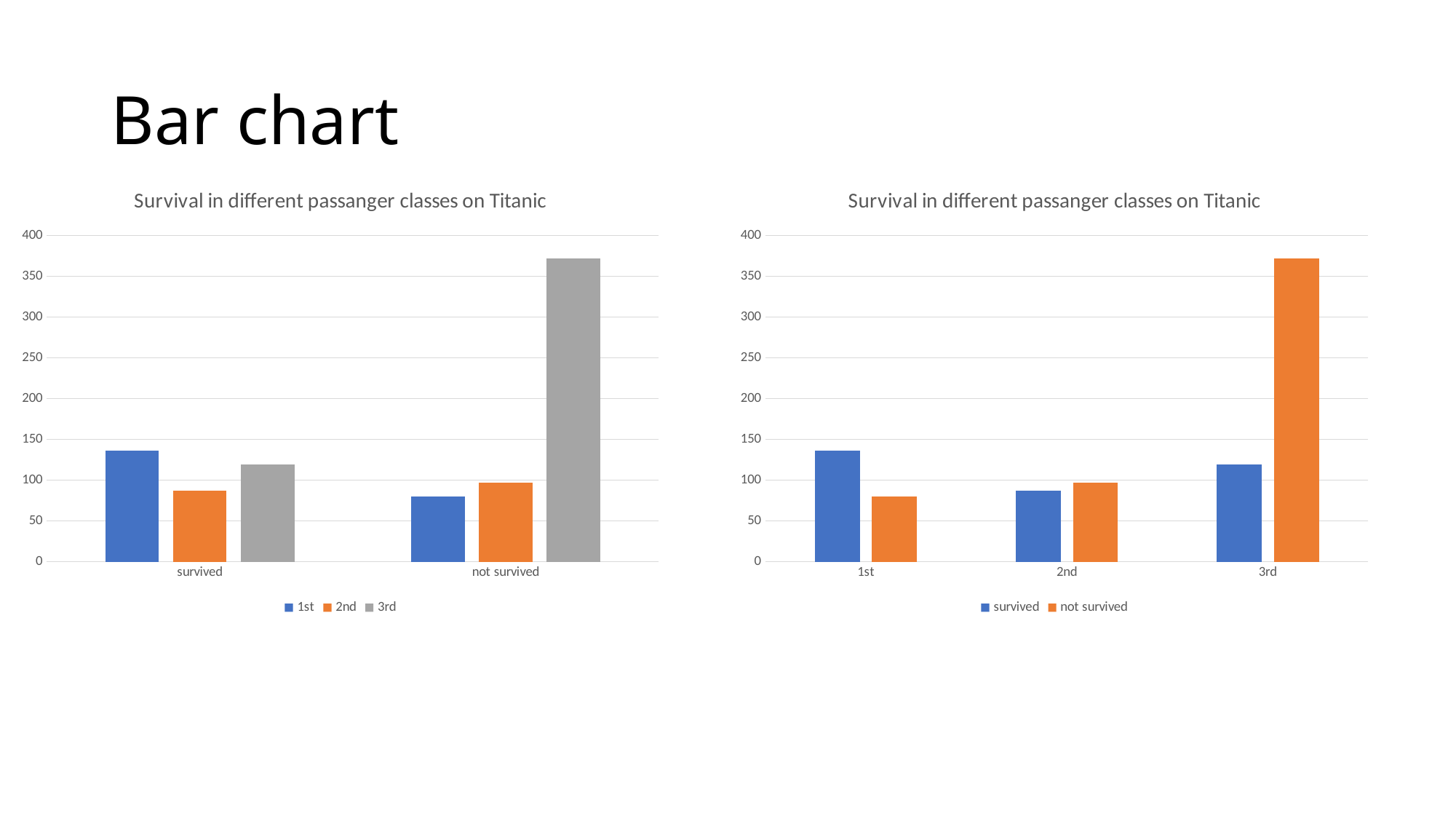
In the right chart, is the 'survived' value for 2nd class greater or less than 100? less How many series does the legend of the right chart list? 2 In the right chart, for 1st class, which is larger: survived or not survived? survived In the left chart, which class has the tallest bar in the 'not survived' category? 3rd In the right chart, is the 'survived' value for 1st class greater or less than 100? greater How many categories are shown on the x axis of the left chart? 2 In the left chart, which class has the shortest bar in the 'survived' category? 2nd How many categories are shown on the x axis of the right chart? 3 In the right chart, is the 'not survived' value for 3rd class greater or less than 350? greater What is the title of the chart on the right of the slide? Survival in different passanger classes on Titanic What kind of chart is the chart on the left of the slide? bar chart How many series does the legend of the left chart list? 3